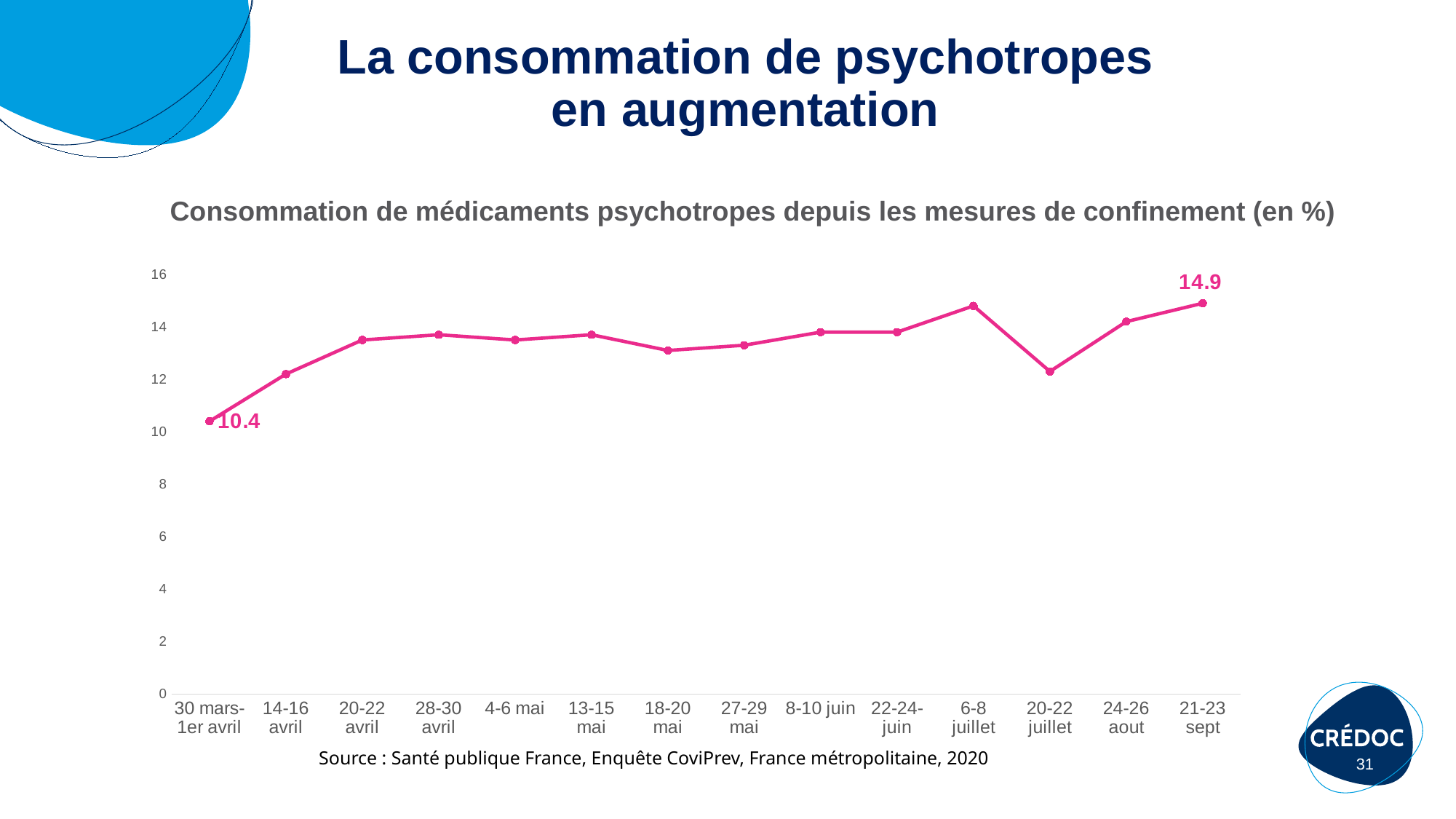
How many periods are plotted on the x axis? 14 What type of chart is shown on the slide? line chart Which is larger, the value for 20-22 juillet or the value for 24-26 aout? 24-26 aout What is the value for 21-23 sept? 14.9 What is the difference between the value for 21-23 sept and the value for 30 mars-1er avril? 4.5 Overall, do the values rise or fall from the first period to the last? rise Which period has the lowest value? 30 mars-1er avril Is the value for 18-20 mai greater or less than 14? less Is the value for 20-22 avril greater or less than 12? greater What is the title of the chart? Consommation de médicaments psychotropes depuis les mesures de confinement (en %) What is the value for 30 mars-1er avril? 10.4 Is the value for 20-22 juillet greater or less than 14? less